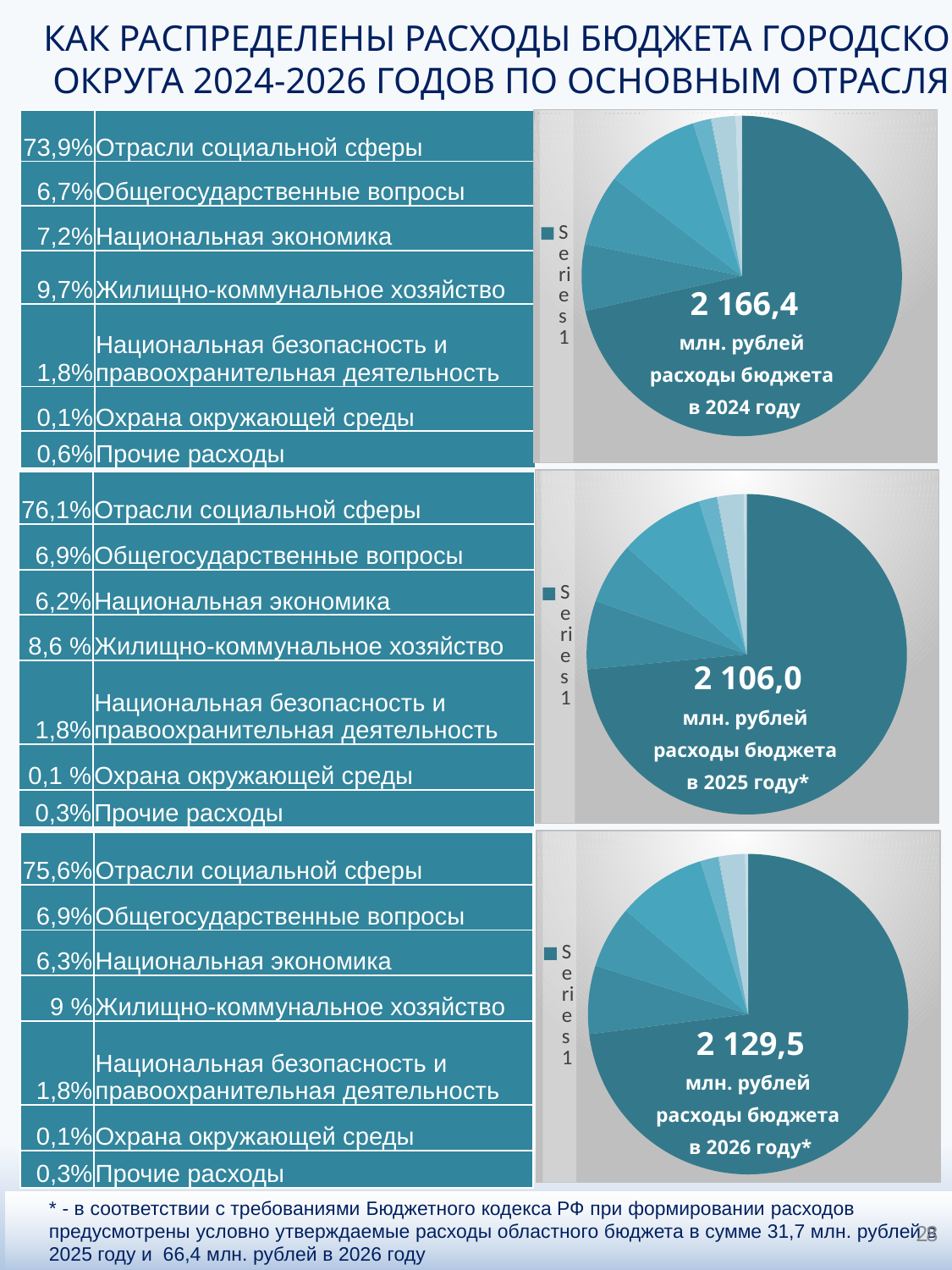
What kind of chart is used to show the 2024 budget expenditures? pie chart What is the difference between the total in the 2024 pie chart and the total in the 2025 pie chart? 60,4 In the 2025 pie chart, what total value is printed in the centre of the pie? 2 106,0 Which total is larger, the 2024 pie chart's or the 2025 pie chart's? 2024 In the 2024 pie chart, what share of the budget goes to Отрасли социальной сферы? 73,9% In the 2025 pie chart, which category has the largest slice? Отрасли социальной сферы How many series does the legend of the 2024 pie chart list? 1 In the 2024 pie chart, which category has the smallest share? Охрана окружающей среды How many pie charts are on the slide? 3 In the 2024 pie chart, what total value is printed in the centre of the pie? 2 166,4 In the 2026 pie chart, what total value is printed in the centre of the pie? 2 129,5 In the 2026 pie chart, what share of the budget goes to Жилищно-коммунальное хозяйство? 9 %